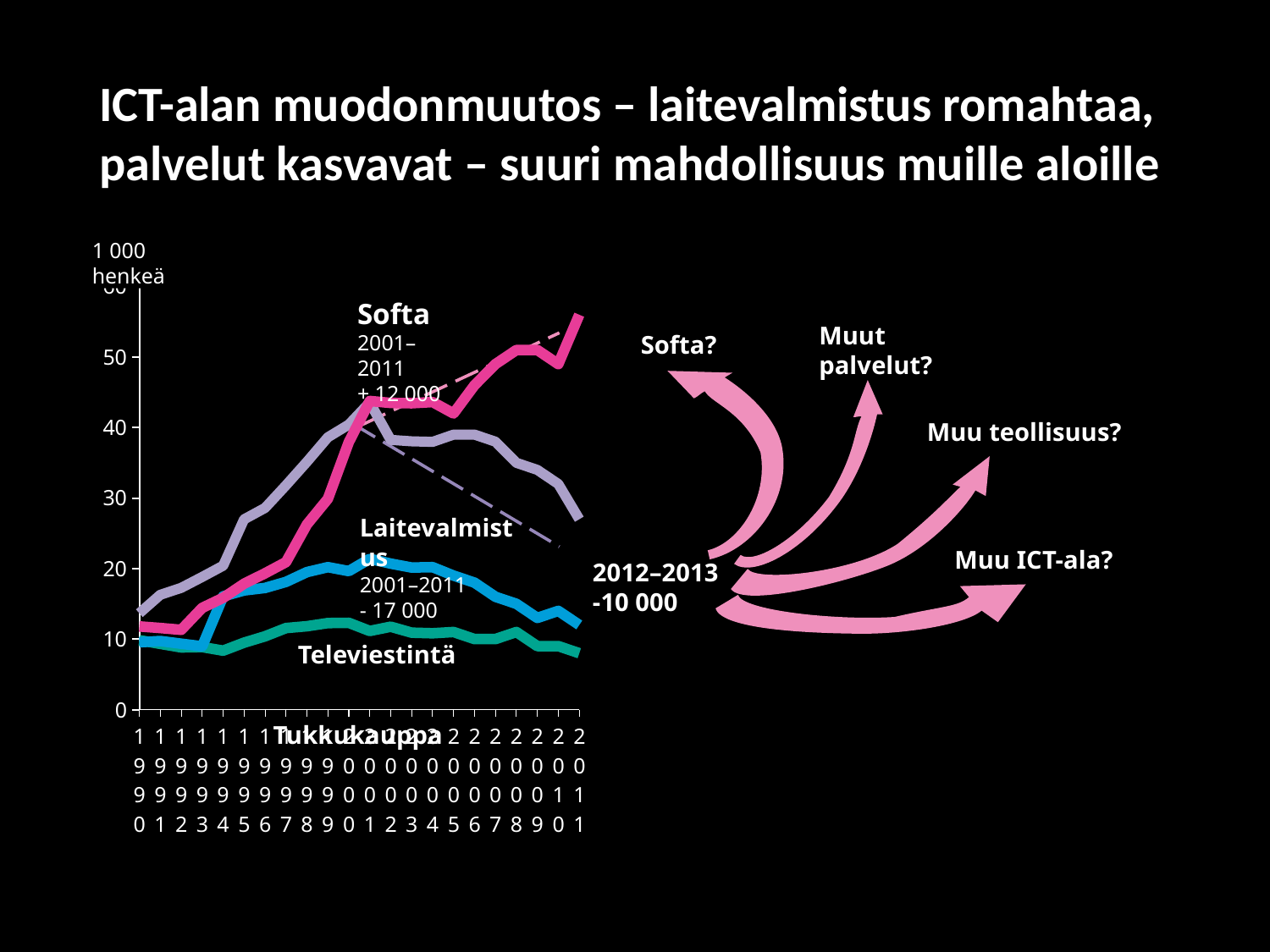
According to the annotation on the chart, what was the change in Laitevalmistus employment from 2001 to 2011? - 17 000 Does the Laitevalmistus line rise or fall between 2001 and 2011? fall What kind of chart is shown on the slide? line chart Is the value for Softa in 2011 greater or less than 50? greater According to the annotation on the chart, what was the change in Softa employment from 2001 to 2011? + 12 000 How many series (lines) are plotted in the chart? 4 Which series has the highest value in 2011? Softa Is the value for Laitevalmistus in 2011 greater or less than 30? less What unit is given for the y axis of the chart? 1 000 henkeä How many years are shown on the x axis of the chart? 22